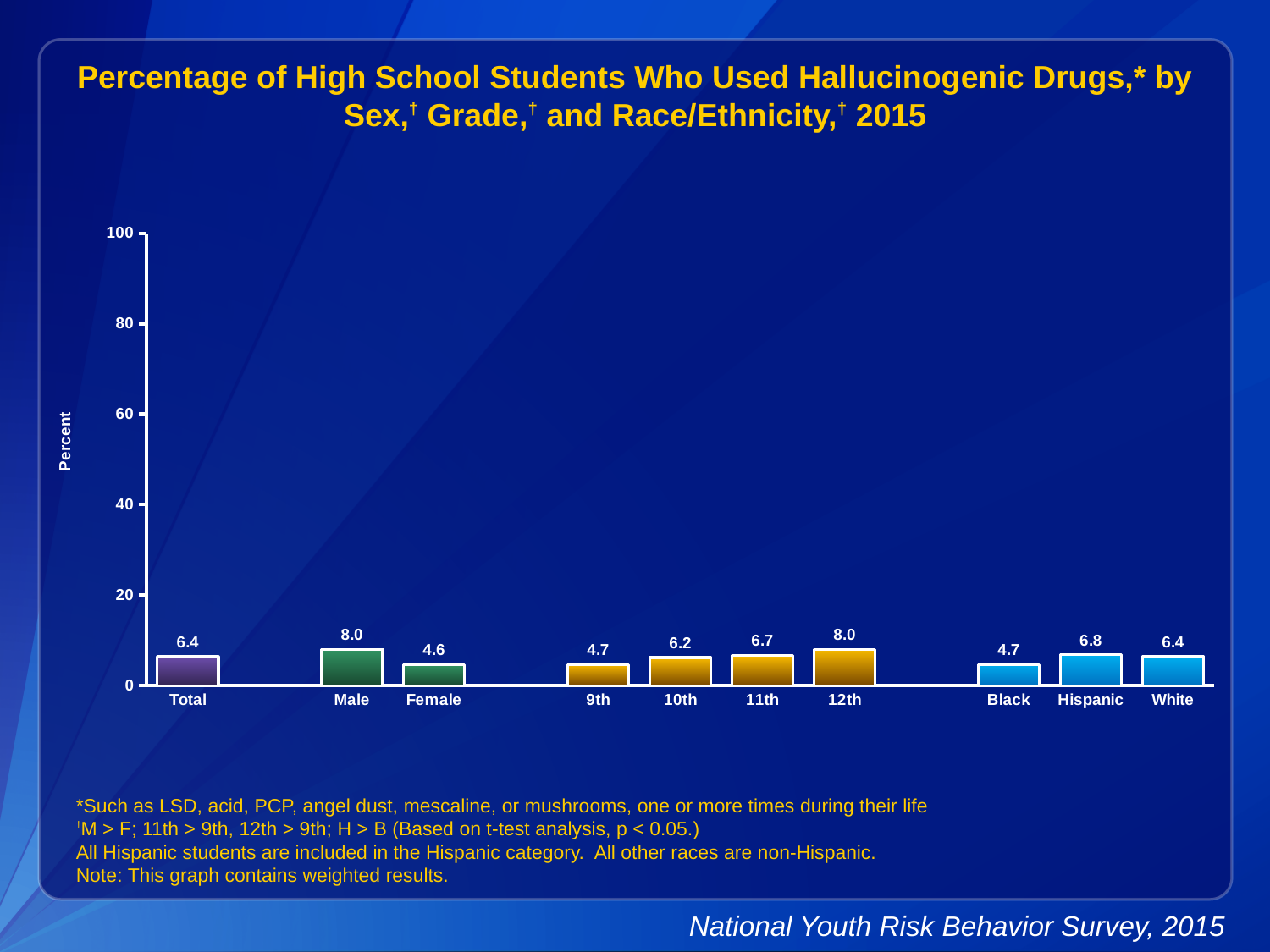
What is the value for Hispanic? 6.8 What kind of chart is shown on the slide? bar chart What is the value for 11th grade? 6.7 What is the value for Total? 6.4 Which category has the lowest value? Female What is the value for Male? 8.0 What is the difference between the values for 12th grade and 9th grade? 3.3 What is the difference between the values for Male and Female? 3.4 What is the value for Female? 4.6 Is the value for 12th grade greater or less than 20? less How many categories are shown on the x axis? 10 Which is larger, the value for Hispanic or the value for Black? Hispanic